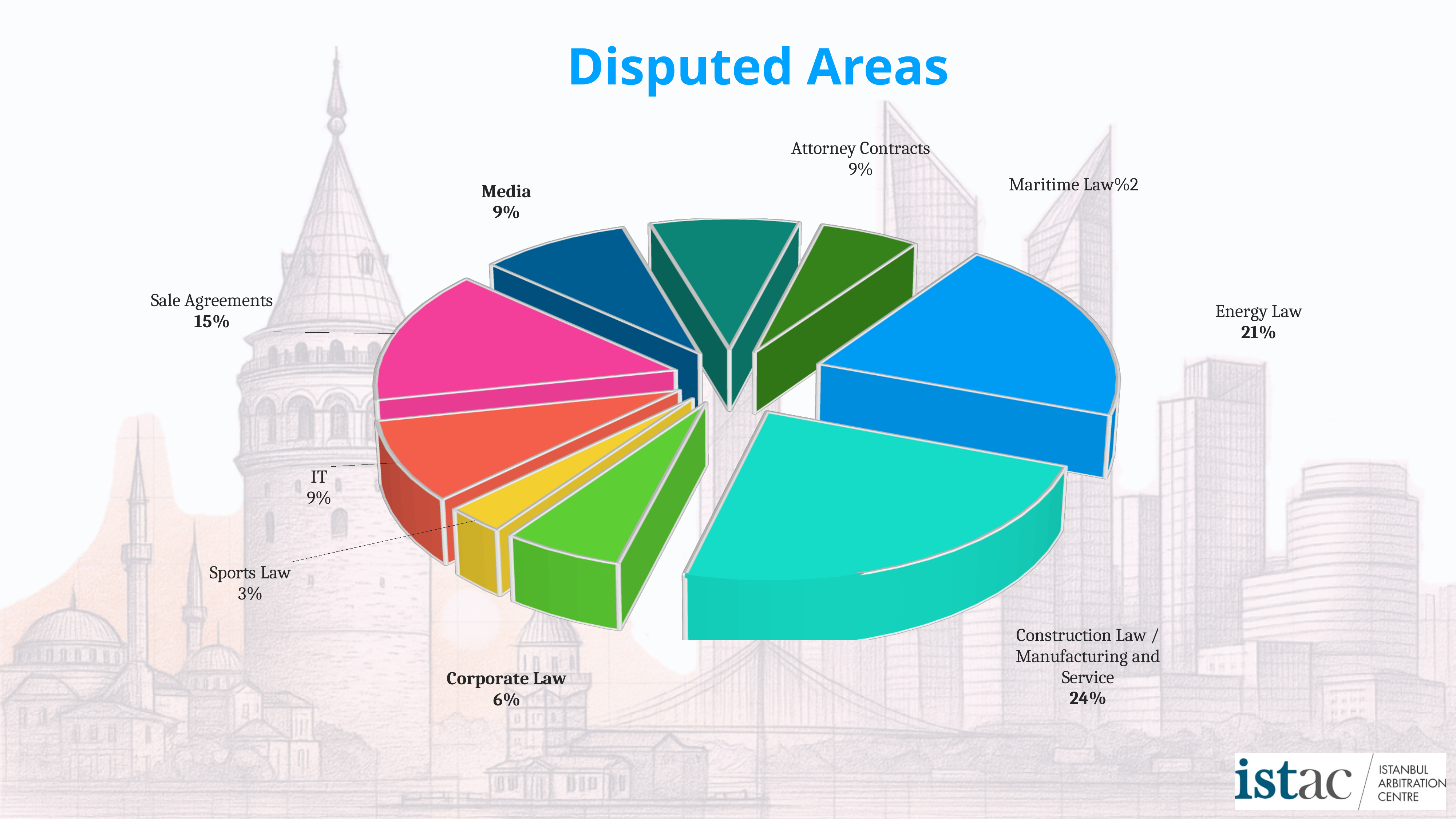
What is the title of the chart? Disputed Areas Which is larger, the share for Corporate Law or the share for IT? IT What share of the pie does Construction Law / Manufacturing and Service hold? 24% What is the value shown for Corporate Law? 6% What is the value shown for Sports Law? 3% What is the value shown for Energy Law? 21% What is the difference between the shares of Energy Law and Sale Agreements? 6% What is the value shown for Sale Agreements? 15% How many slices does the pie chart have? 9 What kind of chart is shown on the slide? Pie chart Which disputed area has the largest share of the pie? Construction Law / Manufacturing and Service